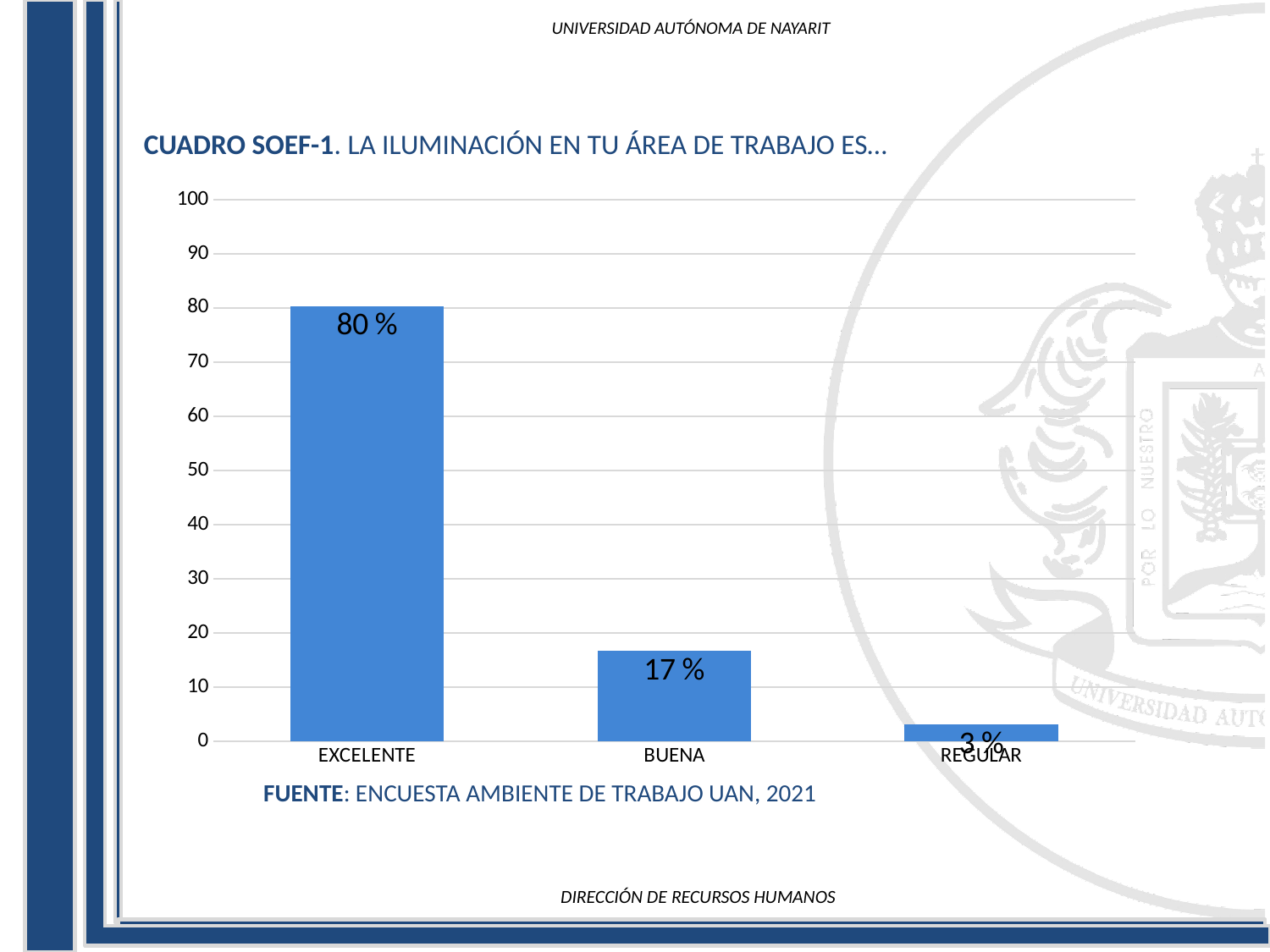
Which category has the lowest value? REGULAR Which category has the highest value? EXCELENTE What is the difference between the values for BUENA and REGULAR? 14 % What is the difference between the values for EXCELENTE and BUENA? 63 % What is the source cited below the chart? ENCUESTA AMBIENTE DE TRABAJO UAN, 2021 Is the value for BUENA greater or less than 20? less What is the value for REGULAR? 3 % Which is larger, the value for BUENA or the value for REGULAR? BUENA What is the value for BUENA? 17 % What kind of chart is shown on the slide? bar chart How many categories are shown on the x axis? 3 What is the value for EXCELENTE? 80 %